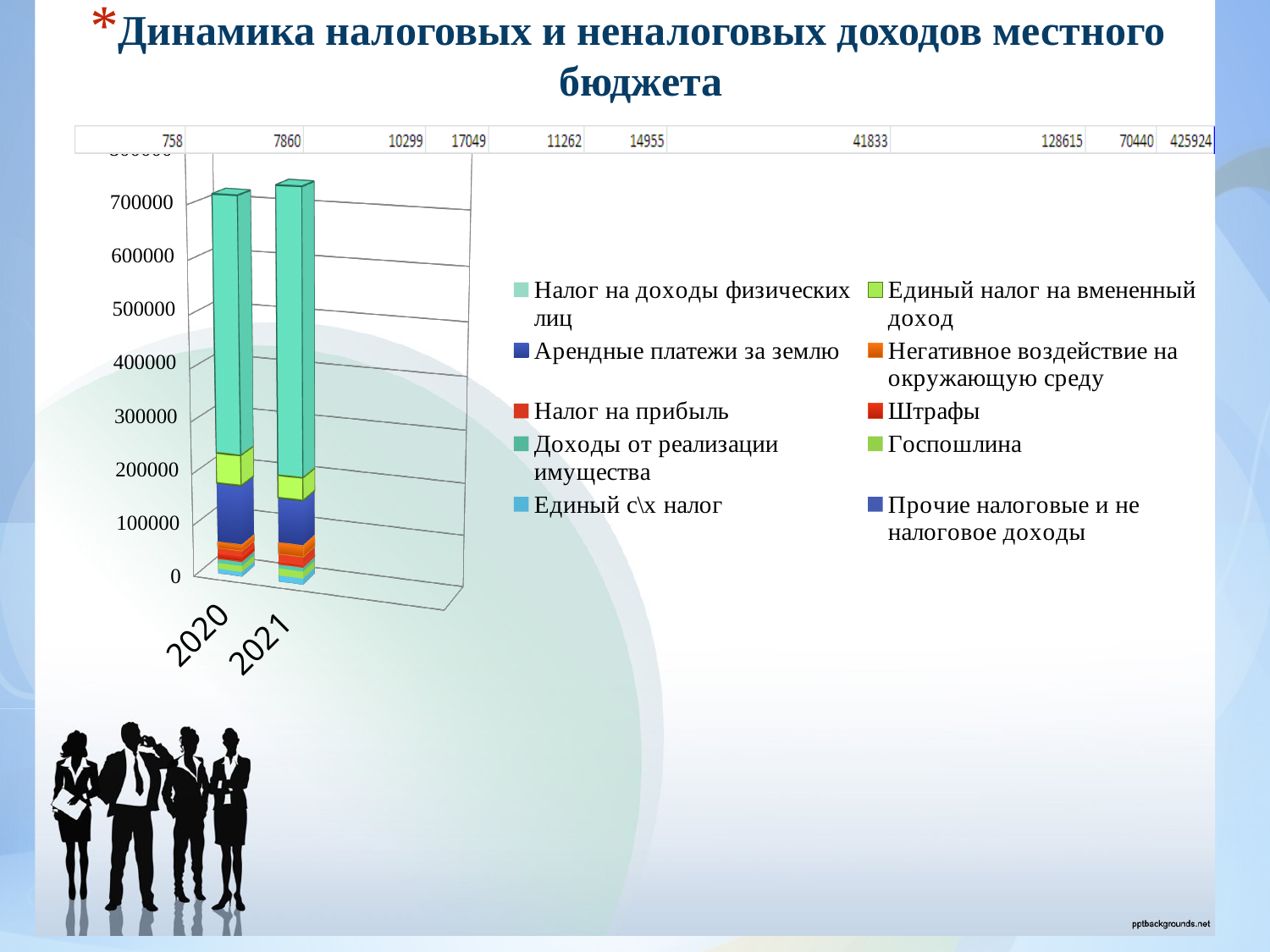
Does the total height of the stacked bars rise or fall from 2020 to 2021? rise Is the total of the 2021 bar greater or less than 600000? greater What is the highest value labelled on the vertical axis? 700000 Is the total of the 2020 bar greater or less than 600000? greater Which series makes up the largest part of the 2021 bar? Налог на доходы физических лиц What is the title of the slide containing the chart? Динамика налоговых и неналоговых доходов местного бюджета How many series does the legend list? 10 What kind of chart is shown on the slide? Stacked bar chart How many categories (years) are plotted on the x axis? 2 Which years are shown on the x axis of the chart? 2020 and 2021 Which series makes up the largest part of the 2020 bar? Налог на доходы физических лиц